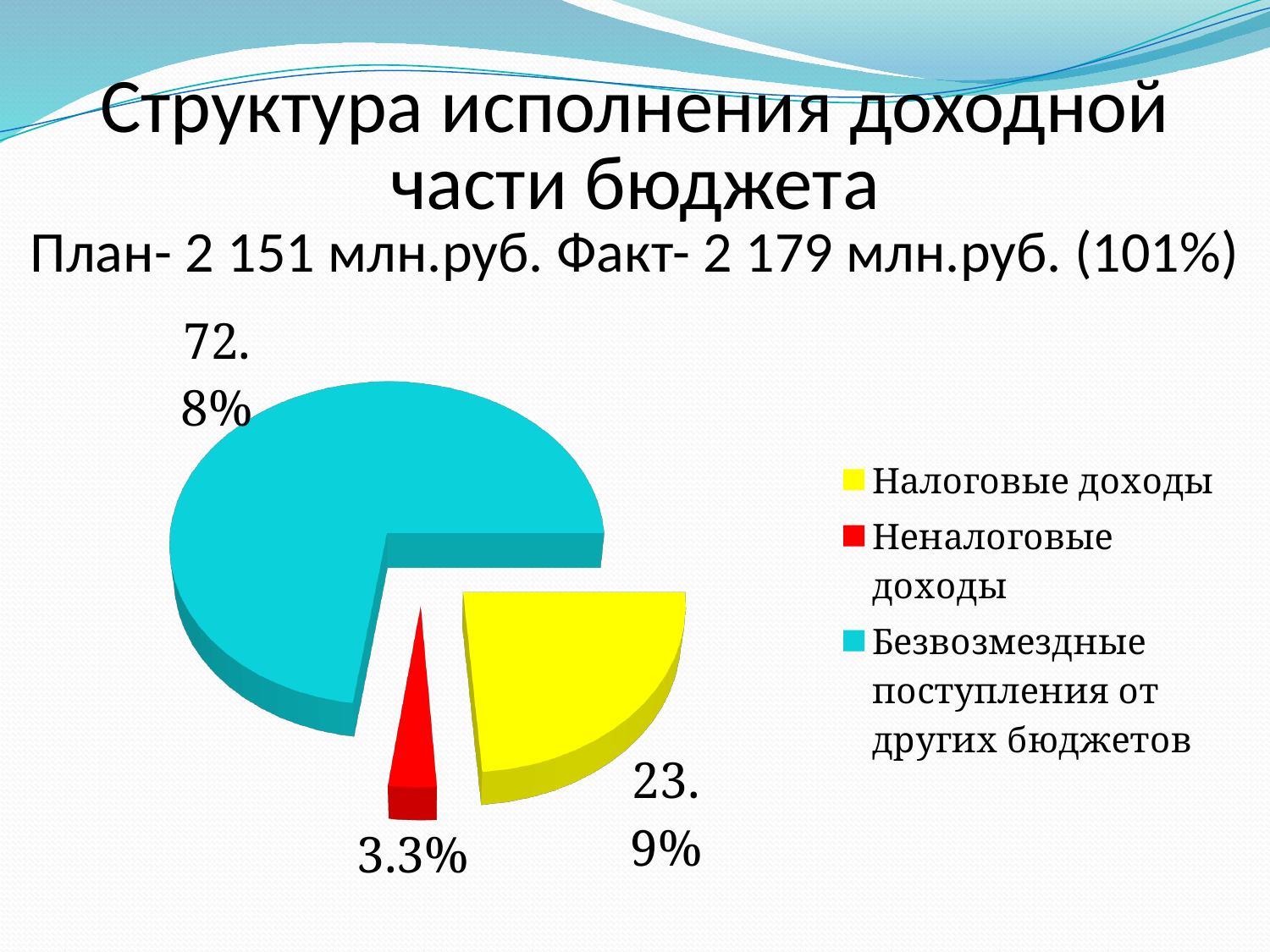
What share of the pie does "Налоговые доходы" have? 23.9% Which category has the smallest slice of the pie? Неналоговые доходы What share of the pie does "Неналоговые доходы" have? 3.3% How many slices does the pie chart have? 3 What is the difference in percentage points between the shares of "Безвозмездные поступления от других бюджетов" and "Налоговые доходы"? 48.9 Which is larger: the share for "Налоговые доходы" or the share for "Неналоговые доходы"? Налоговые доходы What kind of chart is shown on the slide? pie chart What colour is the slice for "Налоговые доходы"? yellow How many entries does the legend list? 3 Which category has the largest slice of the pie? Безвозмездные поступления от других бюджетов What colour is the slice for "Неналоговые доходы"? red What share of the pie does "Безвозмездные поступления от других бюджетов" have? 72.8%